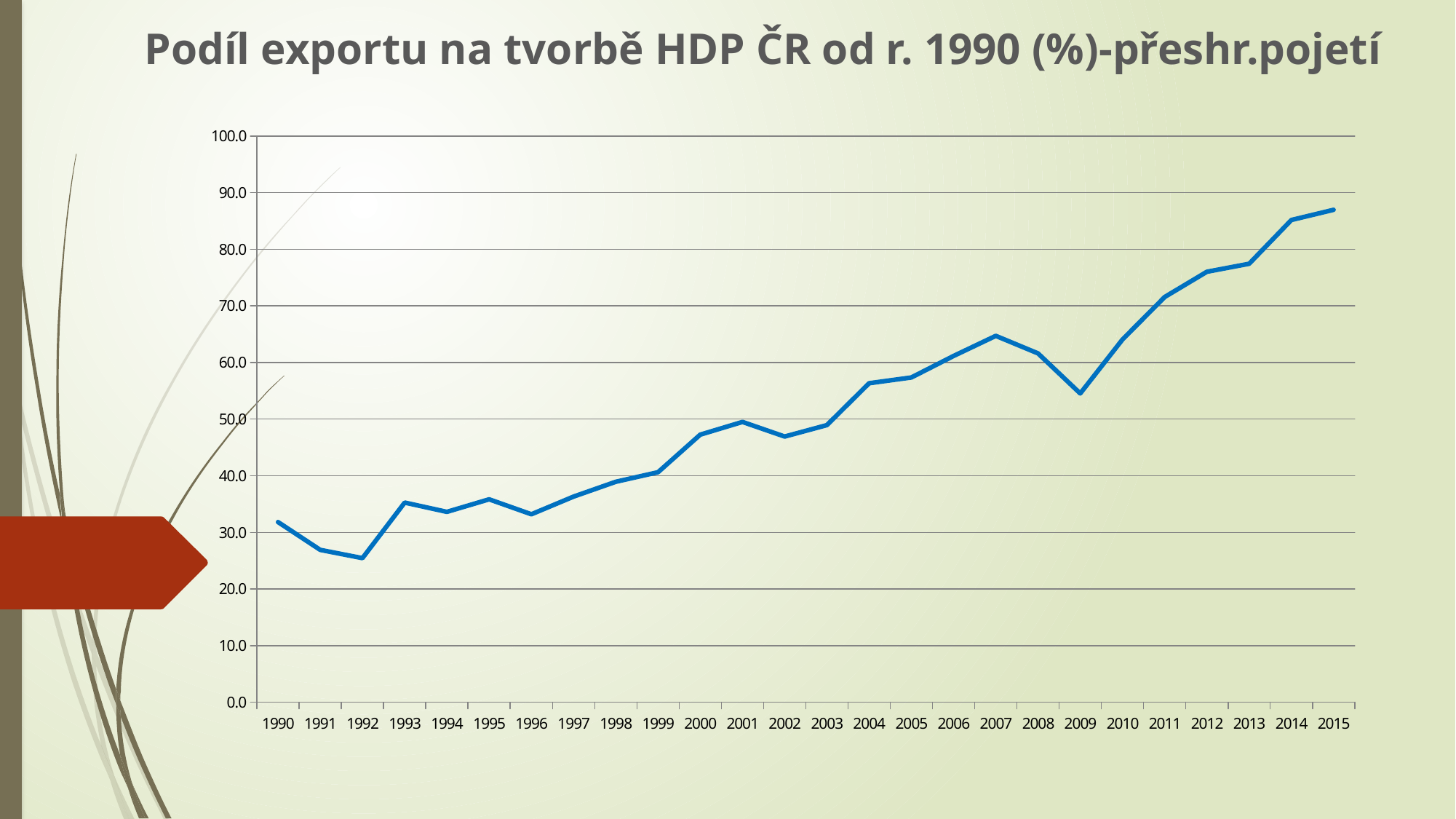
Which year has the larger value, 1990 or 1991? 1990 Is the value for 2015 greater or less than 80.0? greater How many years are plotted along the x axis? 26 Is the value for 2009 greater or less than 60.0? less Which year has the highest value? 2015 What kind of chart is shown on the slide? line chart Is the value for 1992 greater or less than 30.0? less Which year has the larger value, 2007 or 2009? 2007 Overall, do the values rise or fall from 1990 to 2015? rise Which year has the lowest value? 1992 What is the title of the chart on the slide? Podíl exportu na tvorbě HDP ČR od r. 1990 (%)-přeshr.pojetí